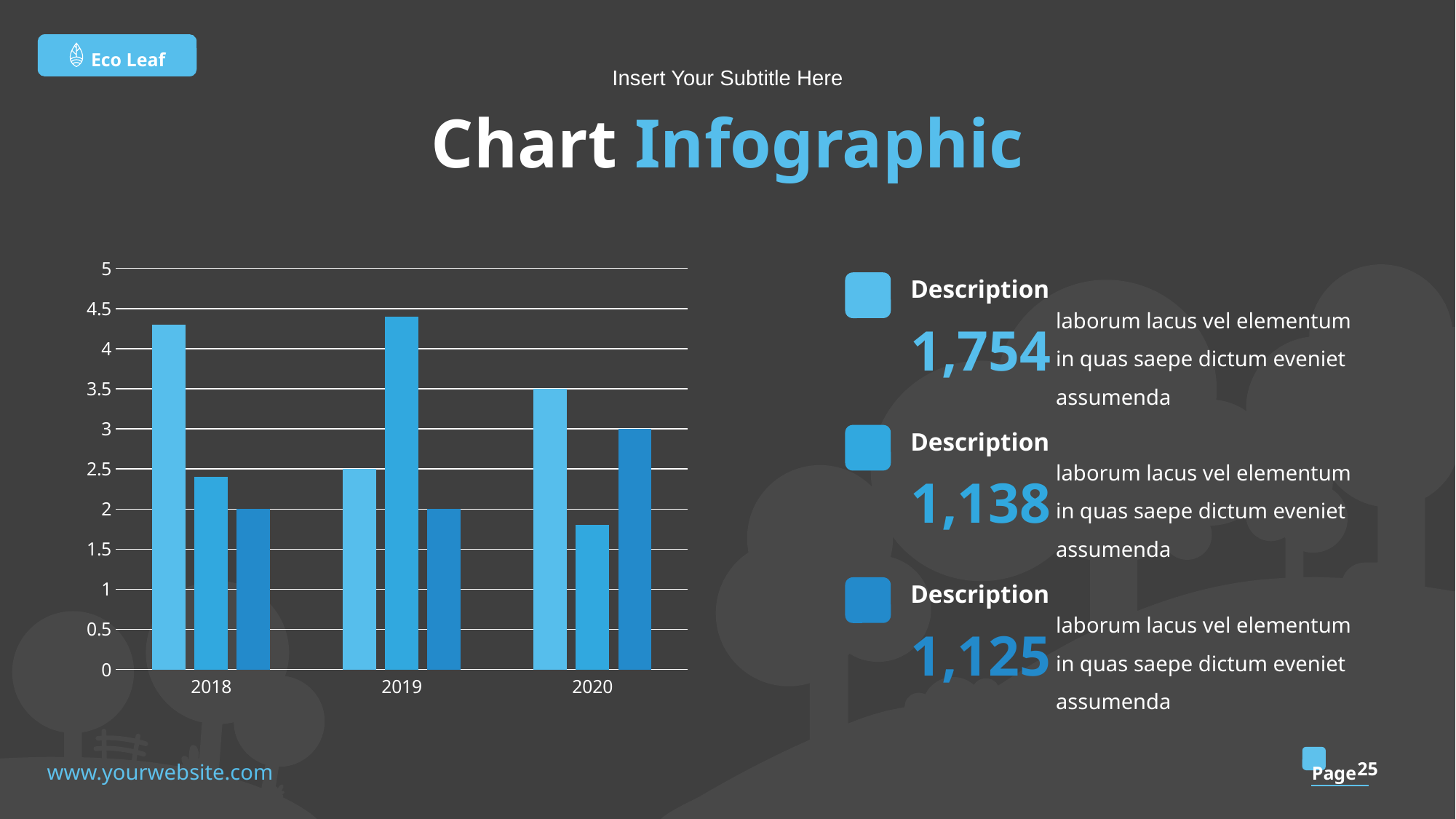
What is the value of the darkest blue (third) bar for 2020? 3 Is the value of the middle bar for 2020 greater or less than 2? less Which of the three bars for 2020 is the lowest? the middle bar What is the value of the lightest blue (first) bar for 2019? 2.5 Which of the three bars for 2019 is the highest? the middle bar How many years are shown on the x axis of the chart? 3 What is the value of the darkest blue (third) bar for 2018? 2 What is the difference between the first bar and the third bar for 2020? 0.5 What kind of chart is shown on the slide? bar chart How many bars are plotted for each year in the chart? 3 Is the value of the lightest blue (first) bar for 2018 greater or less than 4? greater What is the value of the lightest blue (first) bar for 2020? 3.5